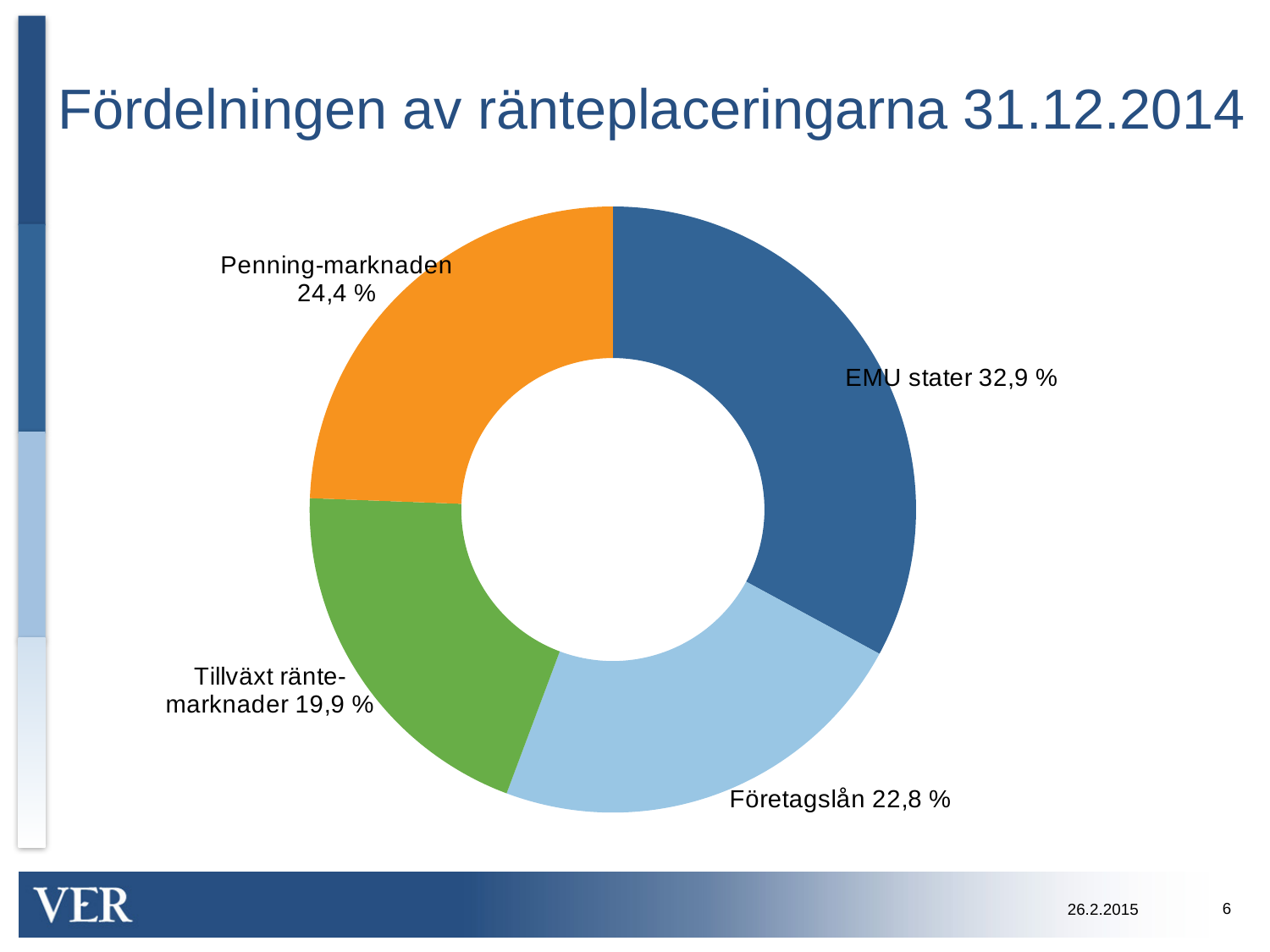
What is the difference in percentage points between EMU stater and Företagslån? 10,1 Which category has the largest share? EMU stater What kind of chart is shown on the slide? Doughnut (pie) chart Which is larger, Penning-marknaden or Företagslån? Penning-marknaden What is the value shown for Penning-marknaden? 24,4 % How many categories are shown in the chart? 4 What is the value shown for Företagslån? 22,8 % What share of the chart does EMU stater represent? 32,9 % Which category has the smallest share? Tillväxt räntemarknader What is the title of the slide? Fördelningen av ränteplaceringarna 31.12.2014 What is the value shown for Tillväxt räntemarknader? 19,9 % What colour is the segment for Tillväxt räntemarknader? Green